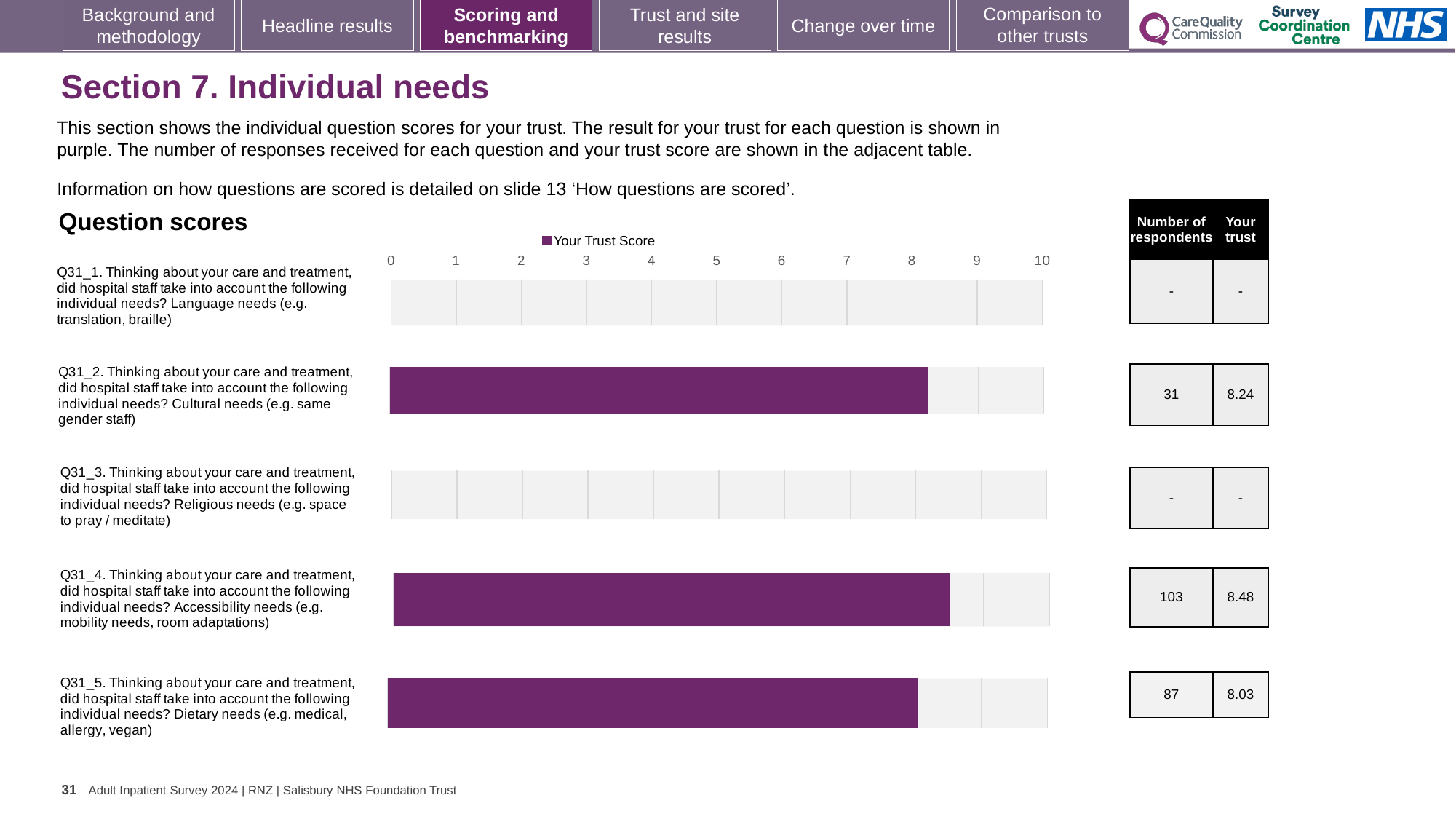
What is the difference between the trust scores for Q31_4 and Q31_5? 0.45 Among the questions with a score shown, which has the lowest trust score? Q31_5 (Dietary needs) What is the trust score for Q31_2 (Cultural needs)? 8.24 What kind of chart is shown on the slide? Bar chart How many respondents answered Q31_4 (Accessibility needs)? 103 How many respondents answered Q31_2 (Cultural needs)? 31 Which has a higher trust score, Q31_2 or Q31_5? Q31_2 How many questions are listed in the chart? 5 Is the trust score for Q31_4 greater or less than 8? greater What is the trust score for Q31_4 (Accessibility needs)? 8.48 Which question has the highest trust score shown? Q31_4 (Accessibility needs) What is the trust score for Q31_5 (Dietary needs)? 8.03